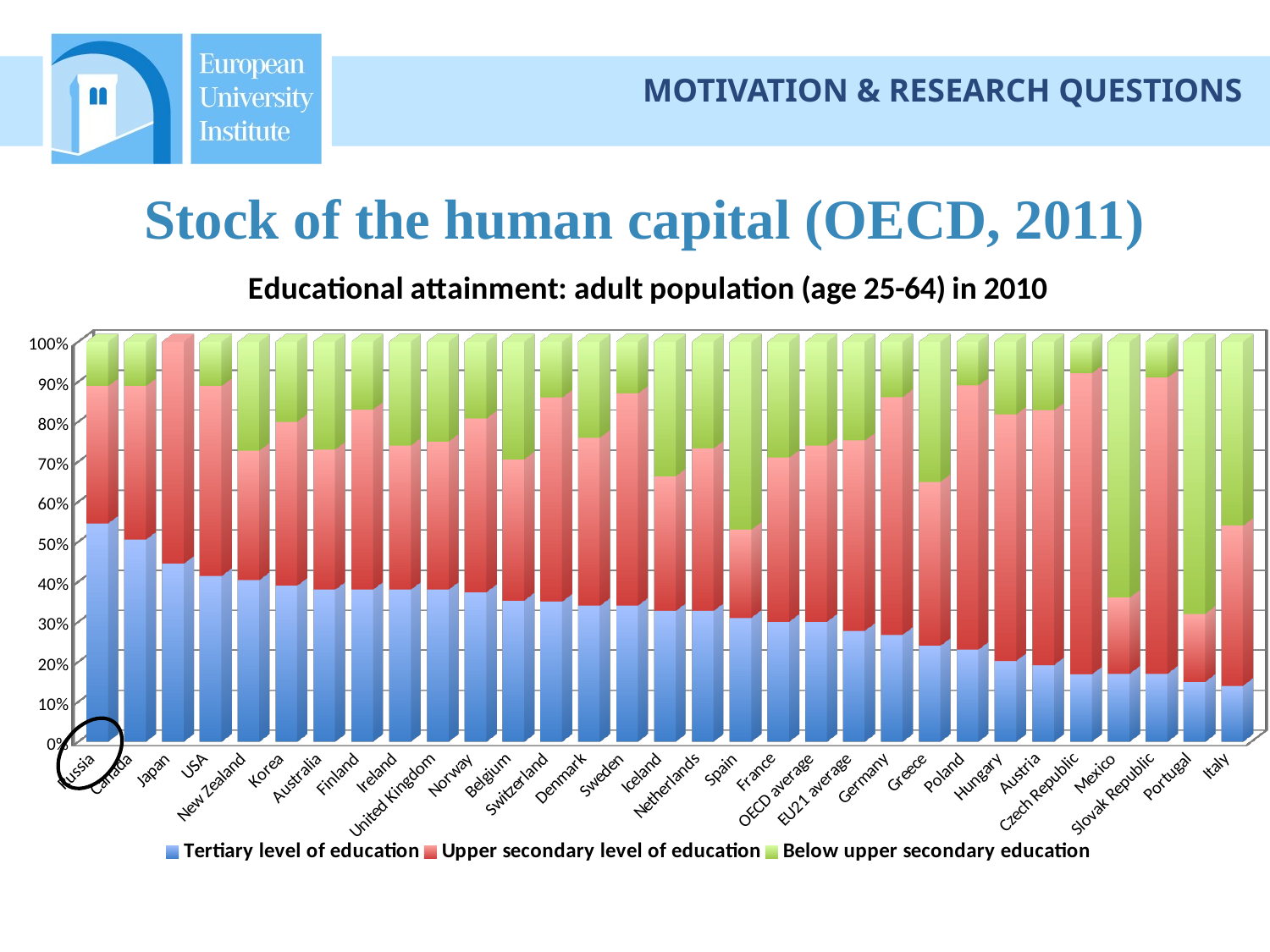
Which country has the highest share of tertiary level of education? Russia How many series does the legend list? 3 How many countries or groups are shown along the x axis? 31 Is the tertiary level of education share for Mexico greater or less than 30%? less Does the share of tertiary level of education rise or fall moving from left to right along the x axis? fall Is the tertiary level of education share for Japan greater or less than 40%? greater What kind of chart is shown on the slide? Stacked bar chart Which colour represents below upper secondary education in the legend? Green What is the title of the chart? Educational attainment: adult population (age 25-64) in 2010 Is the tertiary level of education share for Russia greater or less than 50%? greater Which has a larger share of tertiary level of education, Japan or Germany? Japan